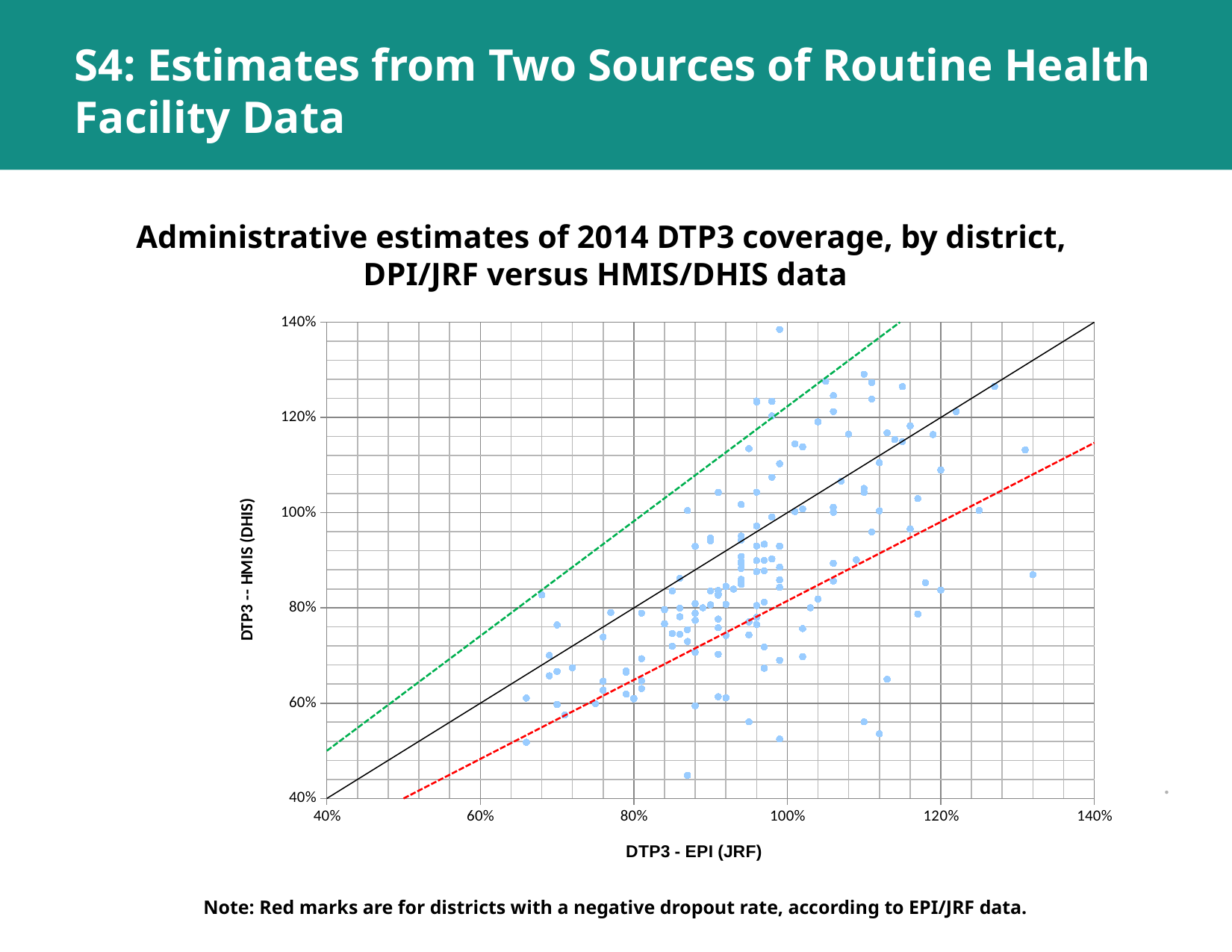
What is the title of the vertical axis? DTP3 -- HMIS (DHIS) Is the EPI (JRF) value of the rightmost plotted point greater or less than 120%? greater What kind of chart is shown on the slide? scatter plot Is the HMIS (DHIS) value of the lowest plotted point greater or less than 60%? less Is the HMIS (DHIS) value of the highest plotted point greater or less than 120%? greater What is the title of the horizontal axis? DTP3 - EPI (JRF)